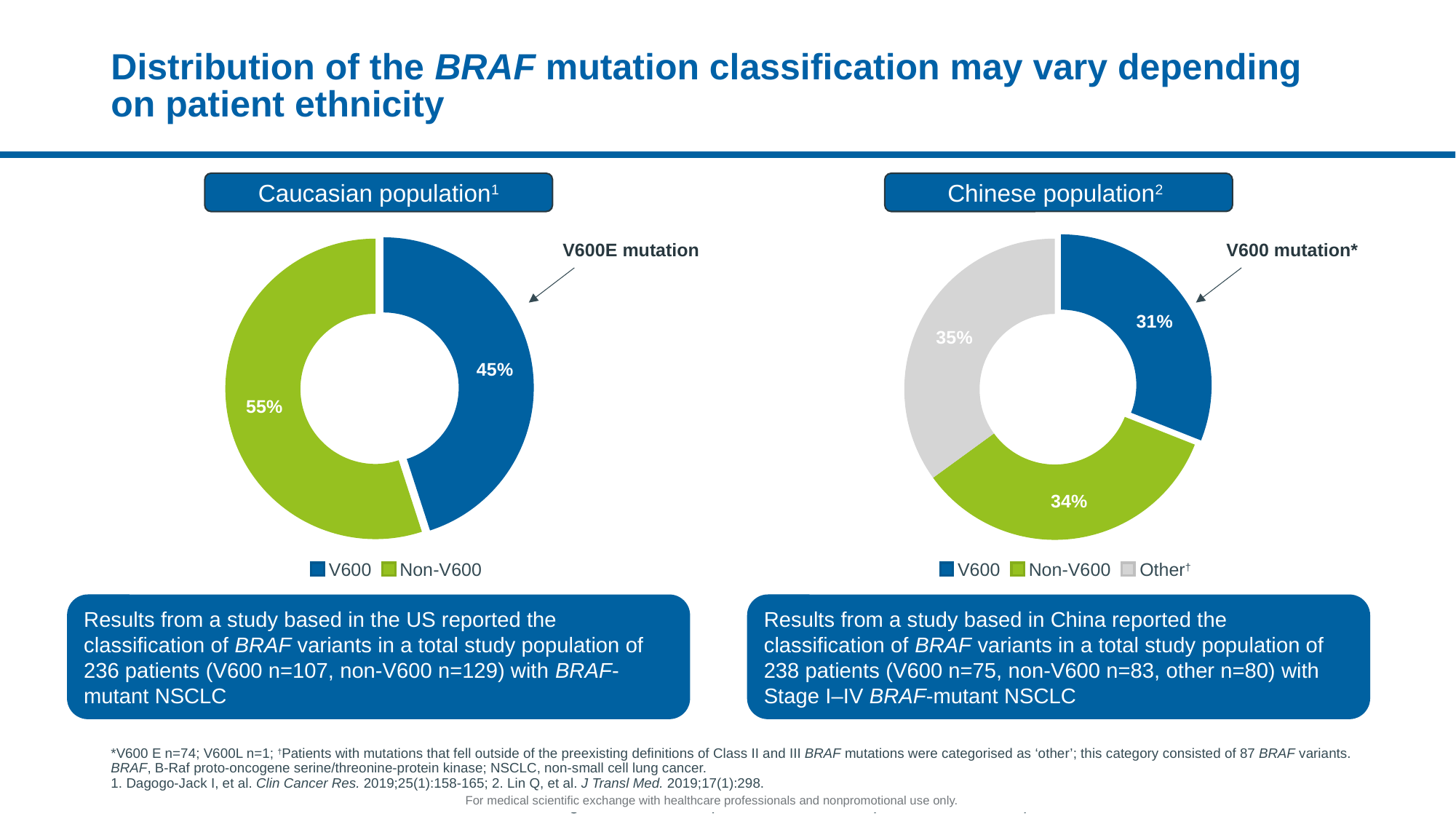
What type of chart is used for the Caucasian population? Doughnut (pie) chart In the Chinese population chart, what share is labelled for Other? 35% In the Chinese population chart, which category has the largest share? Other In the Chinese population chart, what share is labelled for V600? 31% How many entries does the legend of the Caucasian population chart list? 2 In the Caucasian population chart, what is the difference in percentage points between Non-V600 and V600? 10 In the Chinese population chart, what share is labelled for Non-V600? 34% In the Caucasian population chart, which category has the larger share, V600 or Non-V600? Non-V600 In the Chinese population chart, which category has the smallest share? V600 How many categories does the Chinese population chart show? 3 In the Caucasian population chart, what share is labelled for Non-V600? 55% In the Caucasian population chart, what share is labelled for V600? 45%